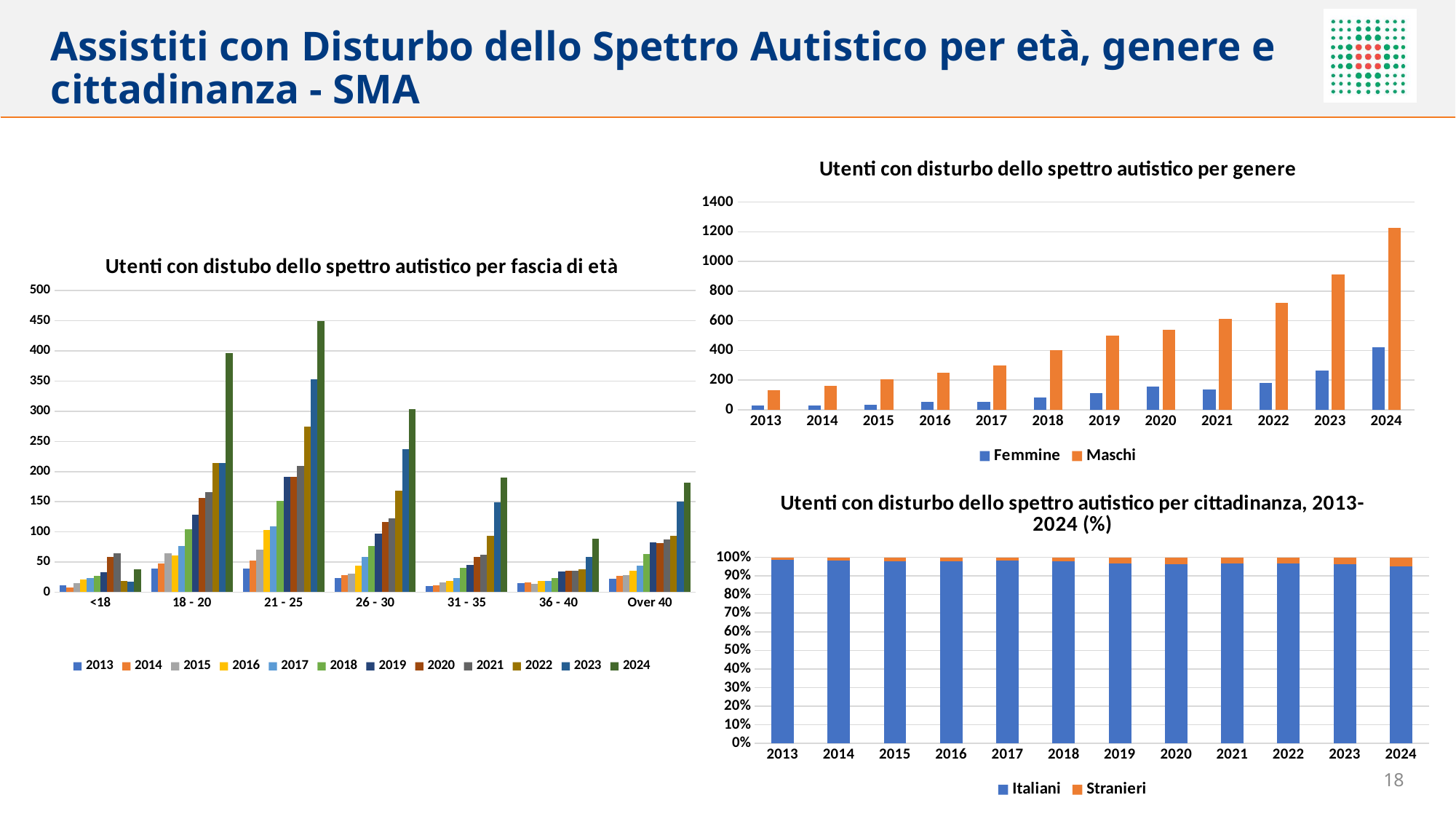
In the 'Utenti con distubo dello spettro autistico per fascia di età' chart, how many age categories are shown on the x axis? 7 In the 'Utenti con distubo dello spettro autistico per fascia di età' chart, is the 2024 value for 21 - 25 greater or less than 400? greater In the 'Utenti con disturbo dello spettro autistico per genere' chart, is the Maschi value for 2024 greater or less than 1000? greater In the 'Utenti con disturbo dello spettro autistico per genere' chart, do the Maschi values rise or fall from 2013 to 2024? rise In the 'Utenti con disturbo dello spettro autistico per cittadinanza, 2013-2024 (%)' chart, is the Italiani share for 2024 greater or less than 90%? greater In the 'Utenti con disturbo dello spettro autistico per genere' chart, which series does the legend list besides Femmine? Maschi In the 'Utenti con distubo dello spettro autistico per fascia di età' chart, how many series does the legend list? 12 In the 'Utenti con distubo dello spettro autistico per fascia di età' chart, which age category has the highest 2024 value? 21 - 25 In the 'Utenti con disturbo dello spettro autistico per genere' chart, which is larger in 2020, Femmine or Maschi? Maschi What kind of chart is the 'Utenti con distubo dello spettro autistico per fascia di età' chart? bar chart In the 'Utenti con disturbo dello spettro autistico per genere' chart, in which year is the Maschi value highest? 2024